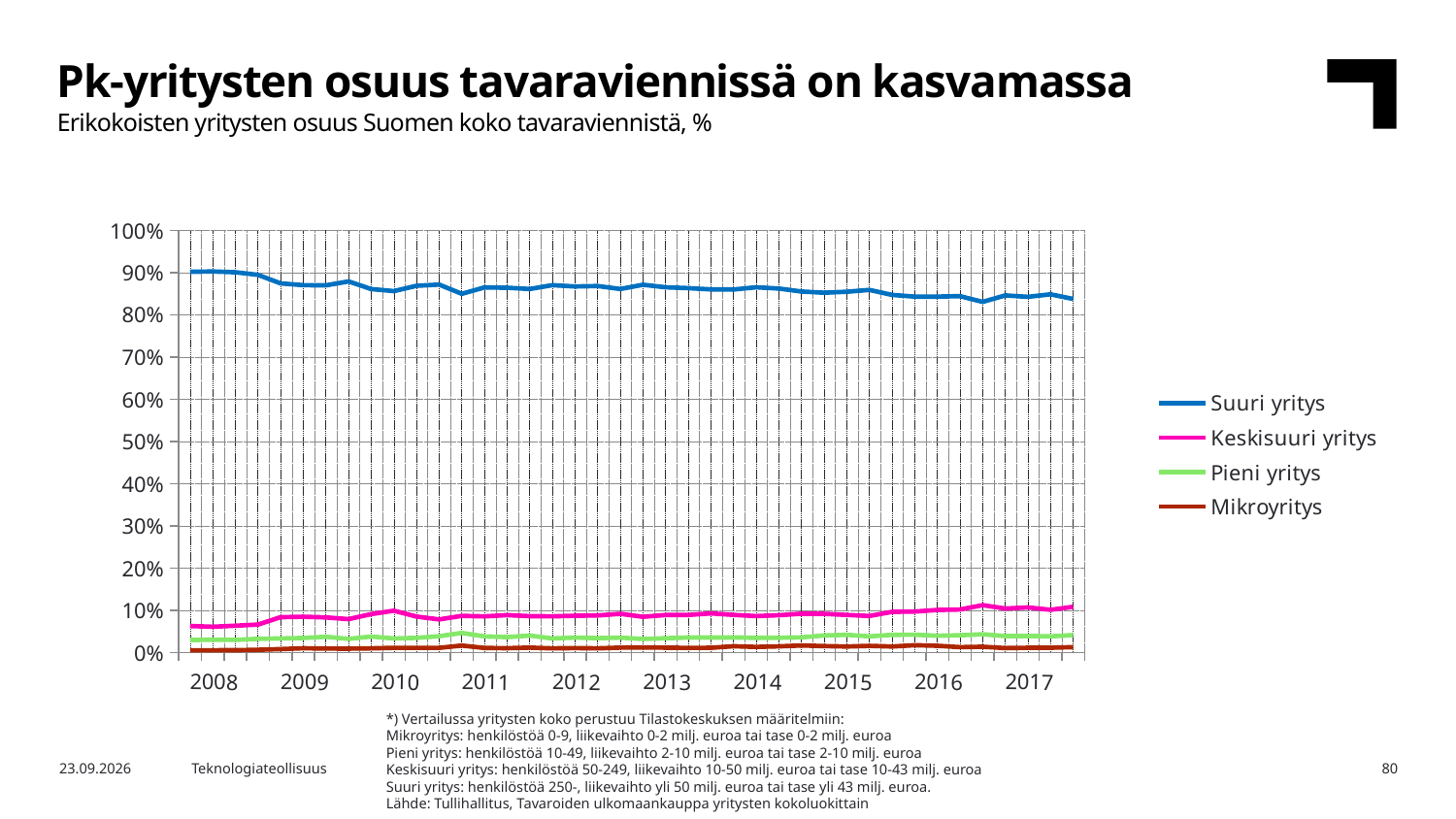
What kind of chart is shown on the slide? line chart Does the share of Keskisuuri yritys rise or fall from 2008 to 2017? rise Is the value for Keskisuuri yritys in 2017 greater or less than 20%? less Which series has the highest share throughout the chart? Suuri yritys Is the value for Suuri yritys in 2008 greater or less than 80%? greater Which series has the lowest share throughout the chart? Mikroyritys How many series does the legend list? 4 How many year labels are shown on the x axis? 10 Is the value for Pieni yritys in 2012 greater or less than 10%? less Which is larger in 2016, the share of Keskisuuri yritys or the share of Pieni yritys? Keskisuuri yritys Which series is drawn in blue? Suuri yritys Does the share of Suuri yritys rise or fall from 2008 to 2017? fall